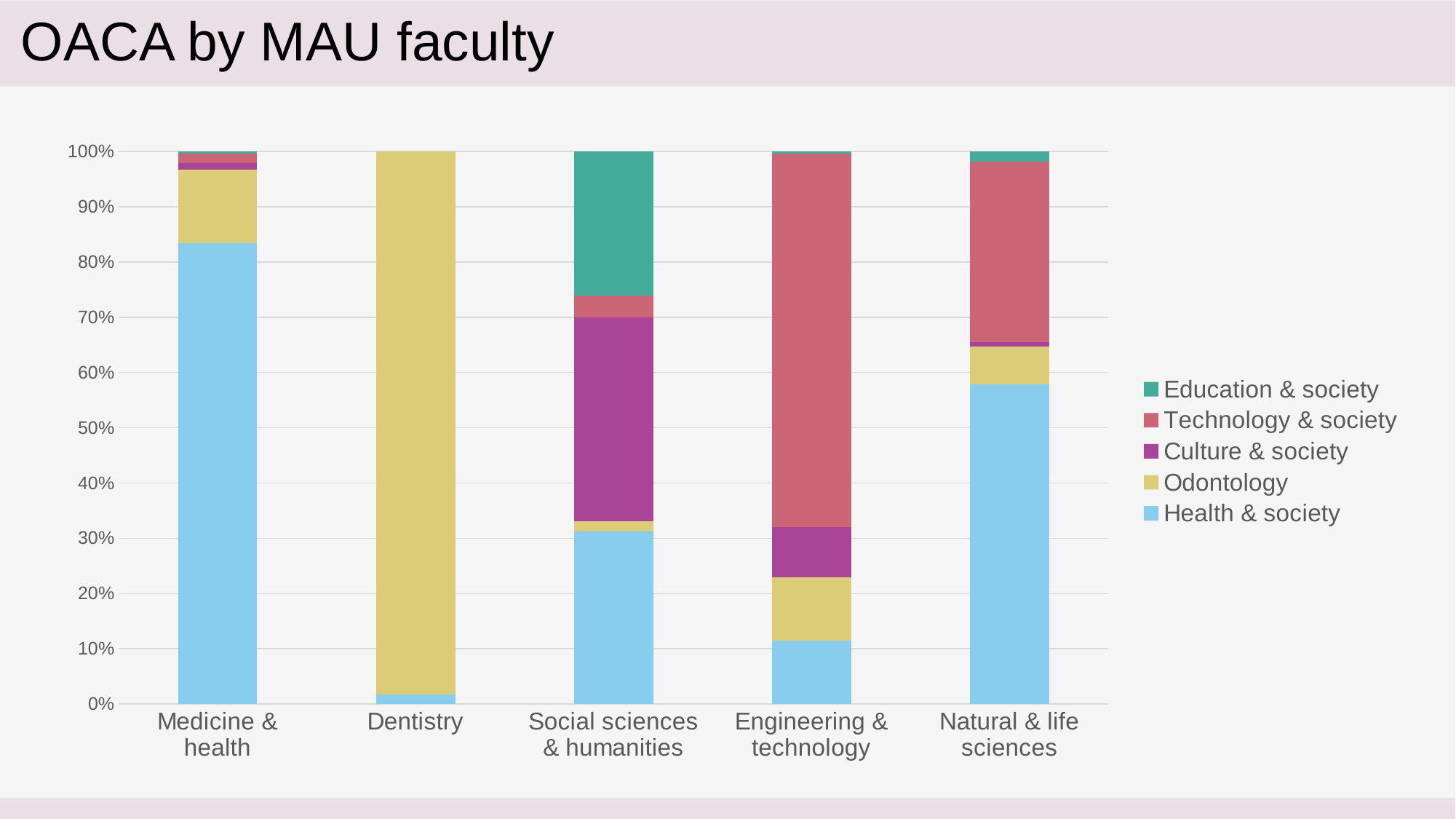
Which faculty has the largest Health & society share? Medicine & health Is the Health & society share for Natural & life sciences greater or less than 50%? greater What is the title of the chart? OACA by MAU faculty What is the total height of the Dentistry stacked bar? 100% Is the Health & society share for Medicine & health greater or less than 80%? greater Is the Odontology share for Dentistry greater or less than 90%? greater Which faculty has the smallest Health & society share? Dentistry How many series does the legend list? 5 Which faculty has the largest Education & society share? Social sciences & humanities How many faculties are shown on the x axis? 5 What kind of chart is shown on the slide? Stacked bar chart